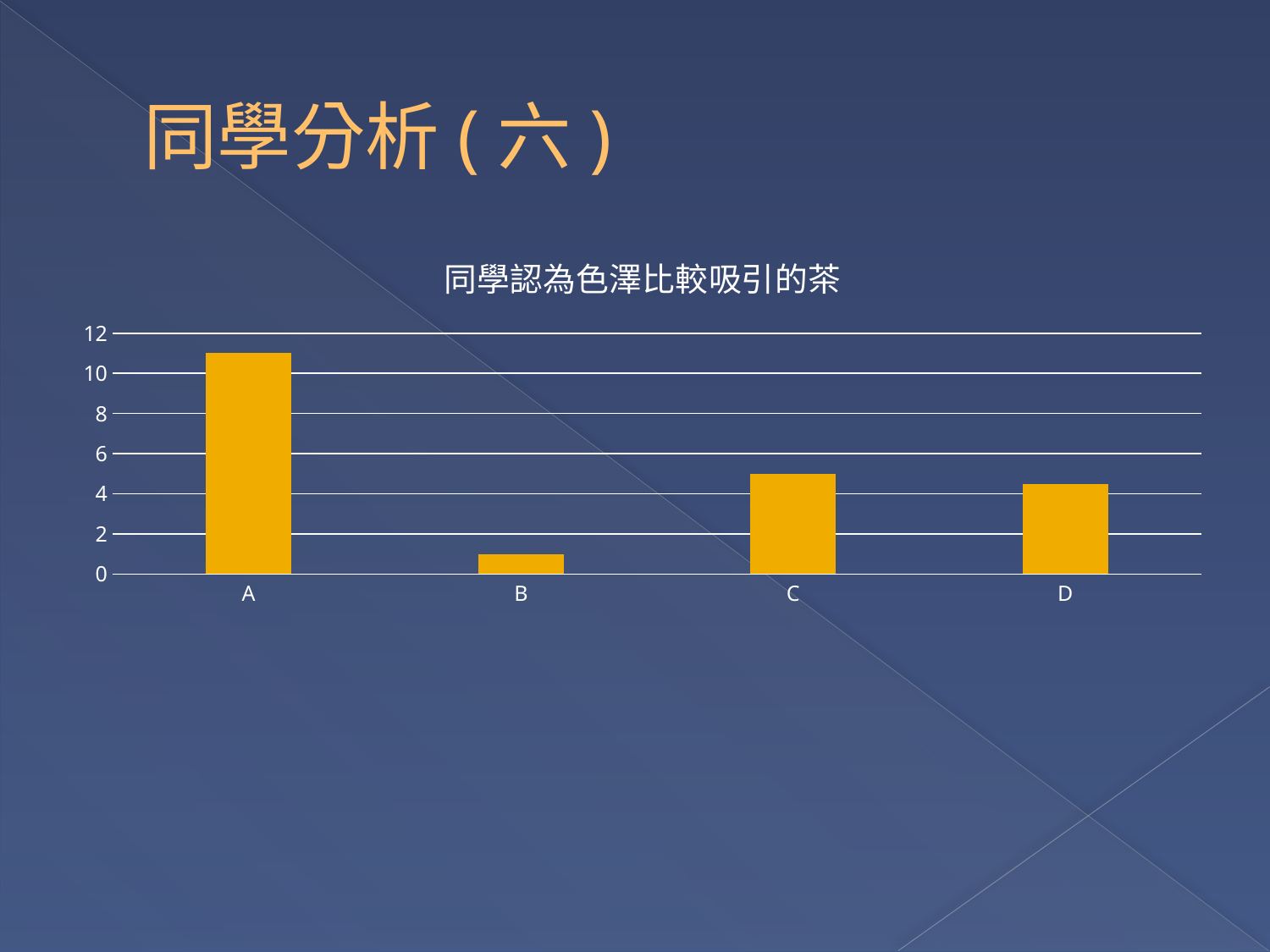
Is the value for B greater or less than 2? less What kind of chart is shown on the slide? bar chart What is the title of the chart? 同學認為色澤比較吸引的茶 Which is larger, the value for B or the value for D? D Is the value for A greater or less than 10? greater Is the value for D greater or less than 6? less What colour are the bars in the chart? orange Which category has the highest bar? A Which is larger, the value for A or the value for C? A How many categories are shown on the x axis of the chart? 4 Which category has the lowest bar? B